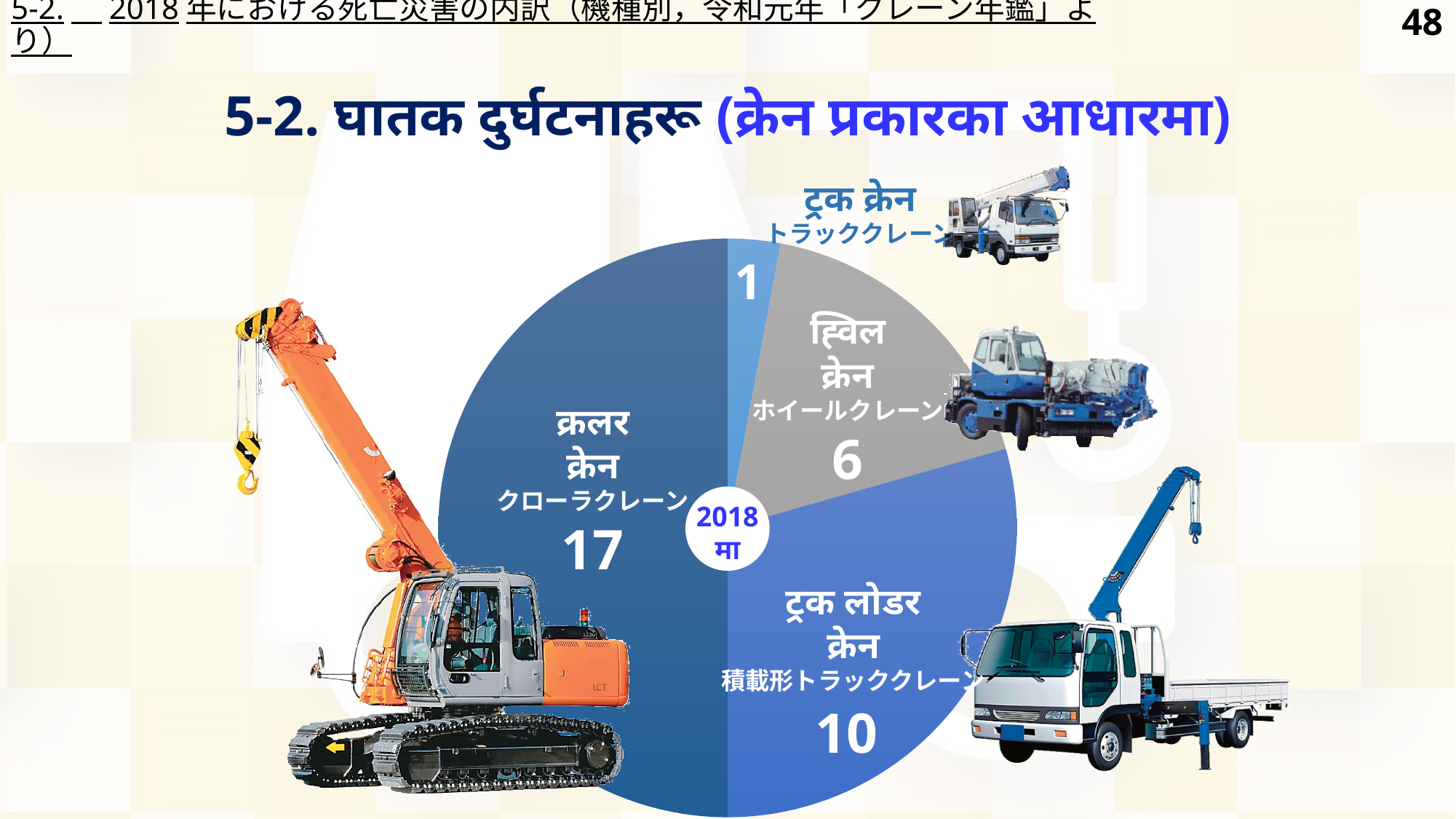
What is the difference between the crawler crane value and the truck loader crane value? 7 What kind of chart is shown on the slide? pie chart Which is larger, the wheel crane value or the truck loader crane value? truck loader crane (ट्रक लोडर क्रेन) Which crane type has the largest slice in the pie chart? crawler crane (क्रलर क्रेन / クローラクレーン) What is the value shown for the truck loader crane (ट्रक लोडर क्रेन / 積載形トラッククレーン) slice? 10 What is the value shown for the wheel crane (ह्विल क्रेन / ホイールクレーン) slice? 6 What share of the pie does the crawler crane slice represent? 50% What is the value shown for the crawler crane (क्रलर क्रेन / クローラクレーン) slice? 17 How many slices does the pie chart have? 4 What is the total of all four slices in the pie chart? 34 What is the value shown for the truck crane (ट्रक क्रेन / トラッククレーン) slice? 1 Which crane type has the smallest slice in the pie chart? truck crane (ट्रक क्रेन / トラッククレーン)